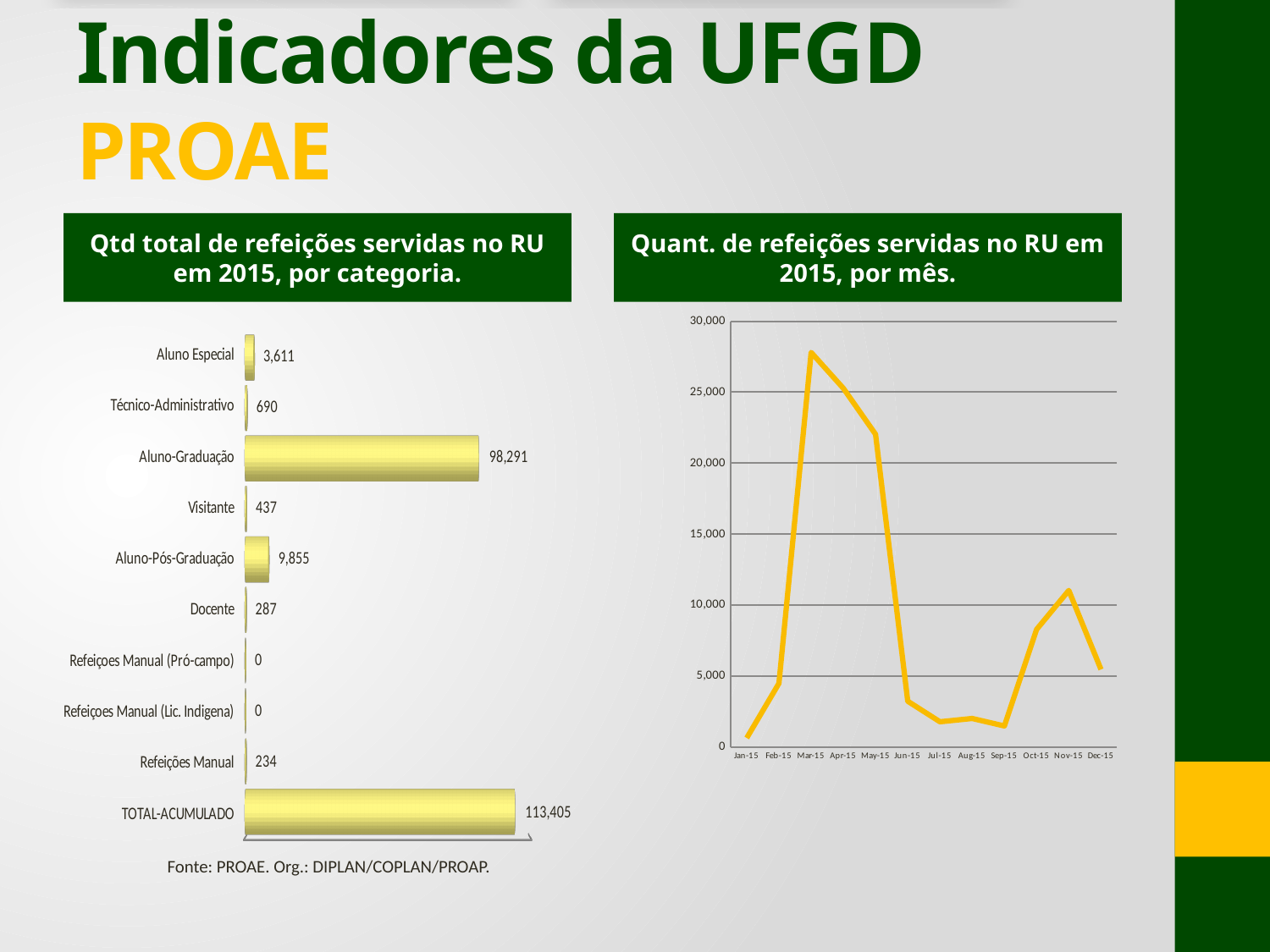
In the chart 'Quant. de refeições servidas no RU em 2015, por mês', do the values rise or fall from Mar-15 to Sep-15? fall In the chart 'Qtd total de refeições servidas no RU em 2015, por categoria', what is the value for Aluno-Graduação? 98,291 In the chart 'Qtd total de refeições servidas no RU em 2015, por categoria', what is the value for Aluno-Pós-Graduação? 9,855 What kind of chart is 'Quant. de refeições servidas no RU em 2015, por mês'? Line chart In the chart 'Qtd total de refeições servidas no RU em 2015, por categoria', which is larger, Visitante or Docente? Visitante How many categories are shown in the chart 'Qtd total de refeições servidas no RU em 2015, por categoria'? 10 In the chart 'Qtd total de refeições servidas no RU em 2015, por categoria', what is the difference between Aluno Especial and Técnico-Administrativo? 2,921 In the chart 'Quant. de refeições servidas no RU em 2015, por mês', is the value for Jul-15 greater or less than 5,000? less In the chart 'Qtd total de refeições servidas no RU em 2015, por categoria', what is the value for TOTAL-ACUMULADO? 113,405 In the chart 'Qtd total de refeições servidas no RU em 2015, por categoria', which category other than TOTAL-ACUMULADO has the highest value? Aluno-Graduação What kind of chart is 'Qtd total de refeições servidas no RU em 2015, por categoria'? Bar chart In the chart 'Quant. de refeições servidas no RU em 2015, por mês', is the value for Mar-15 greater or less than 25,000? greater